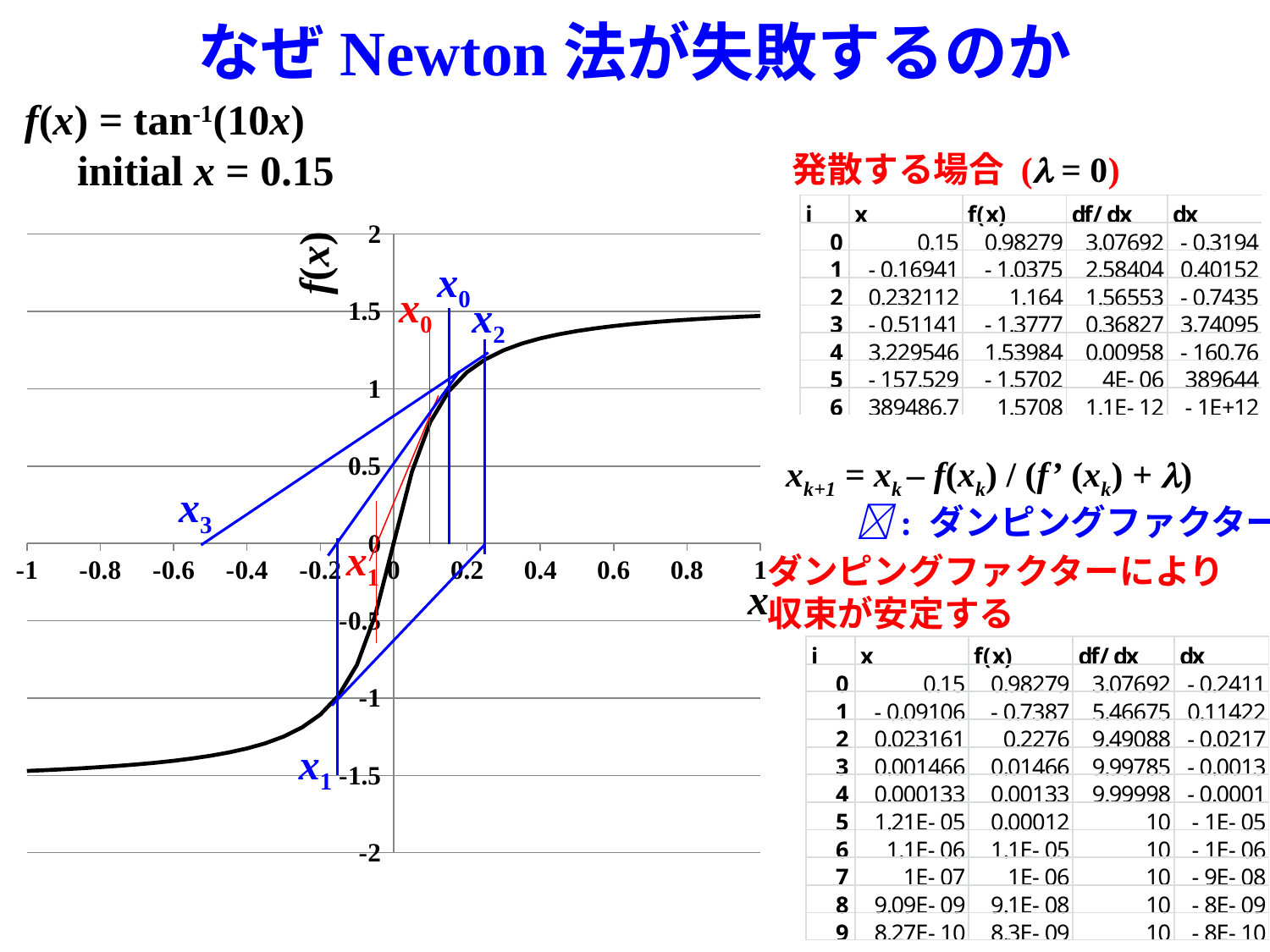
What kind of chart is shown on the left of the slide? line chart Is the value of f(x) at x = 0.2 greater or less than 0.5? greater Does the plotted curve f(x) rise or fall as x increases from -1 to 1? rise What is the lowest value shown on the x axis of the chart? -1 Which is larger, f(x) at x = 0.6 or f(x) at x = -0.6? f(x) at x = 0.6 What is the value of f(x) where the curve crosses x = 0? 0 What initial value of x is stated for the Newton iteration shown on the chart? 0.15 Is the value of f(x) at x = 0.8 greater or less than 1? greater What is the label of the vertical axis of the chart? f(x) What is the highest value shown on the y axis of the chart? 2 Is the value of f(x) at x = -0.8 greater or less than -1? less How many tick labels are shown along the x axis of the chart? 11